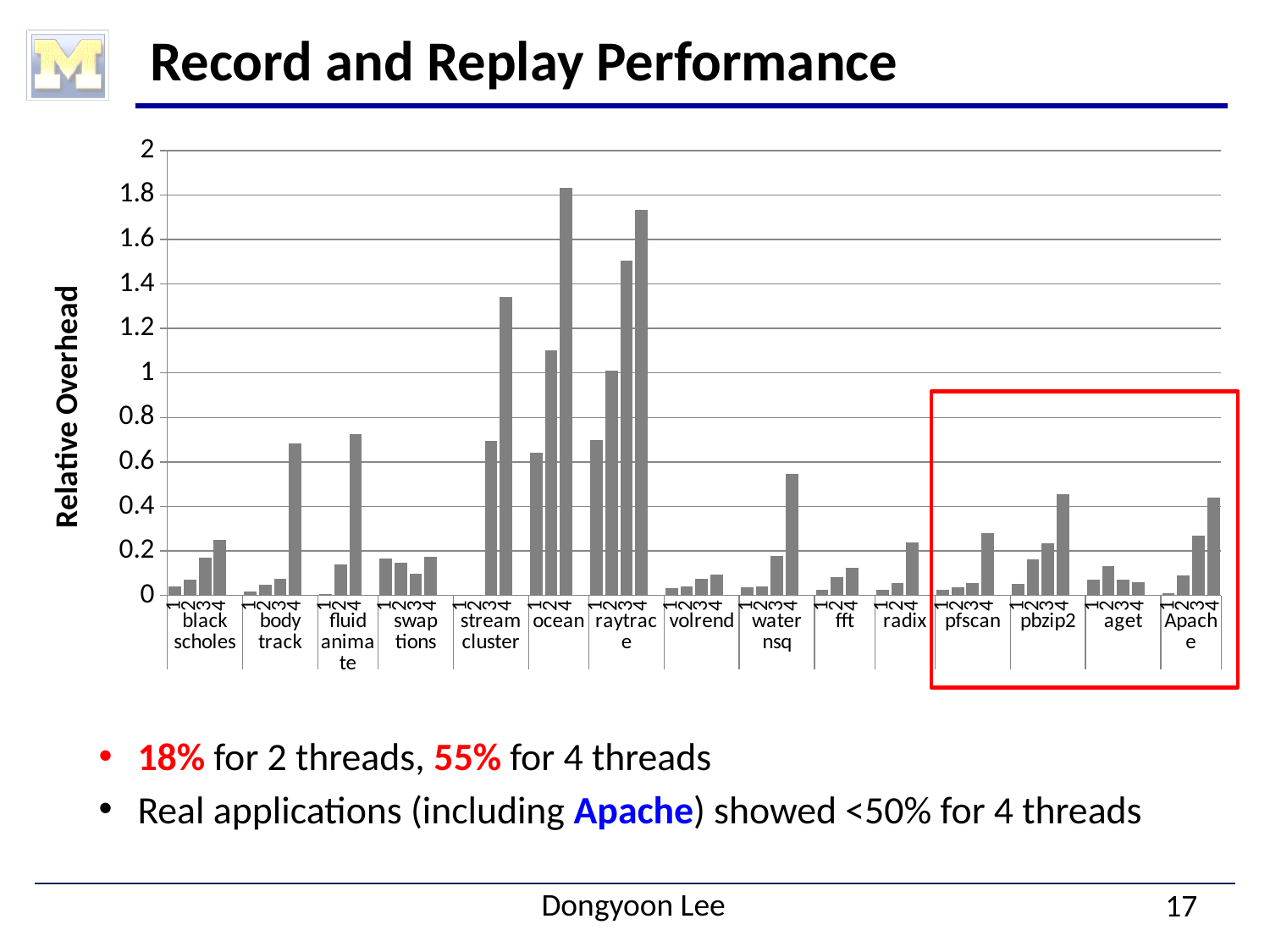
Which benchmark groups are enclosed by the red box on the chart? pfscan, pbzip2, aget, Apache Which benchmark has the tallest bar in the chart? ocean What is the label of the y axis of the chart? Relative Overhead Is the tallest bar for ocean greater or less than 1.6? greater Which has the taller maximum bar, streamcluster or bodytrack? streamcluster Is the tallest bar for Apache greater or less than 0.6? less Is the tallest bar for bodytrack greater or less than 0.6? greater How many benchmark groups are shown along the x axis of the chart? 15 Within the ocean group, do the bars rise or fall as the thread count increases? rise What kind of chart is shown on the slide? bar chart